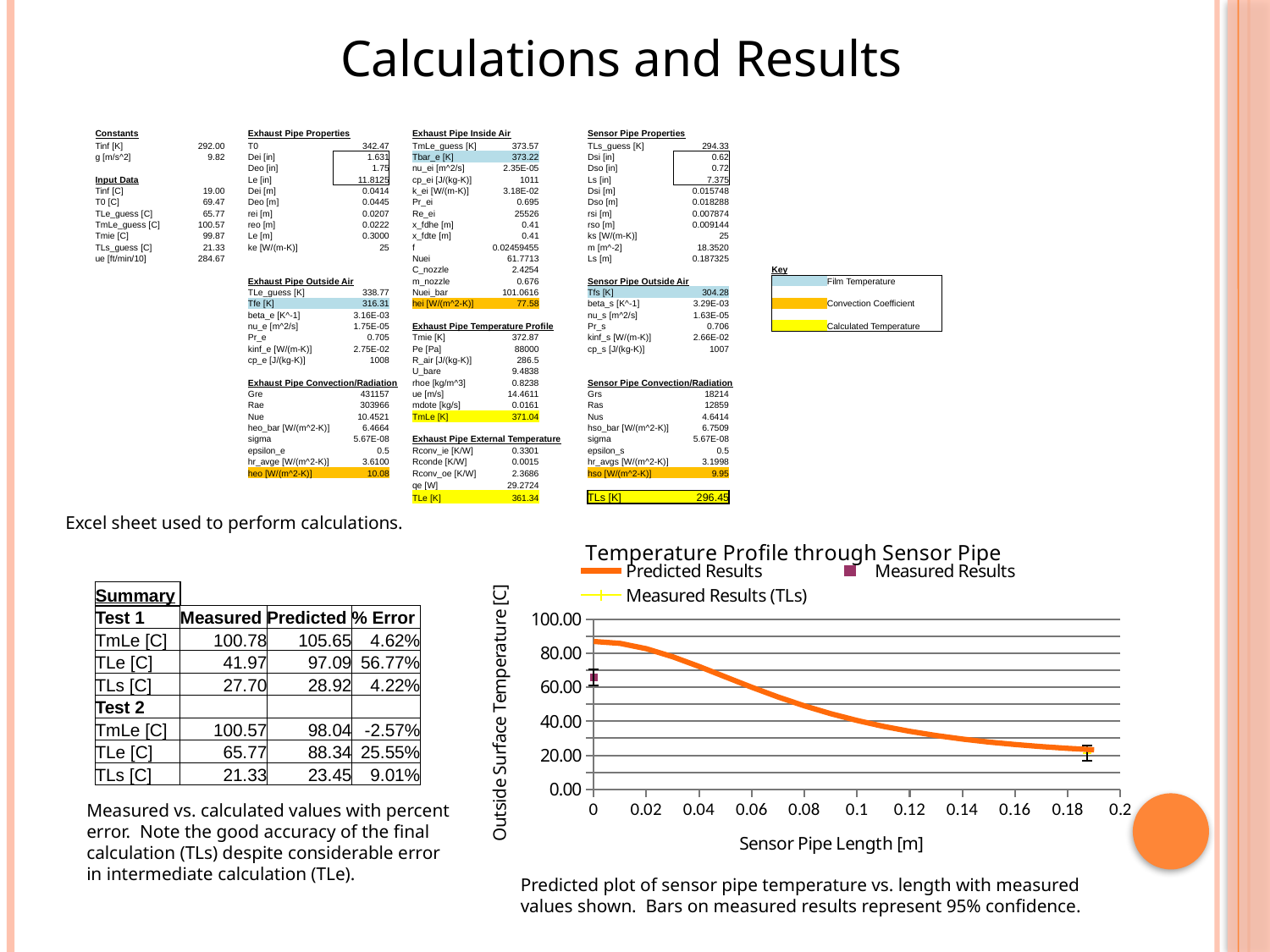
In the Temperature Profile through Sensor Pipe chart, which is larger at a Sensor Pipe Length of 0 m: the Predicted Results value or the Measured Results value? Predicted Results In the Temperature Profile through Sensor Pipe chart, is the Predicted Results value at a Sensor Pipe Length of 0 m greater or less than 80? greater In the Temperature Profile through Sensor Pipe chart, do the Predicted Results rise or fall as Sensor Pipe Length increases? fall How many series does the legend of the Temperature Profile through Sensor Pipe chart list? 3 What is the title of the chart on the slide? Temperature Profile through Sensor Pipe What is the label of the x axis in the Temperature Profile through Sensor Pipe chart? Sensor Pipe Length [m] How many Measured Results data points are plotted in the Temperature Profile through Sensor Pipe chart? 1 In the Temperature Profile through Sensor Pipe chart, is the Predicted Results value at a Sensor Pipe Length of 0.04 m greater or less than 60? greater In the Temperature Profile through Sensor Pipe chart, is the Measured Results value at a Sensor Pipe Length of 0 m greater or less than 80? less What kind of chart is the Temperature Profile through Sensor Pipe chart? line chart